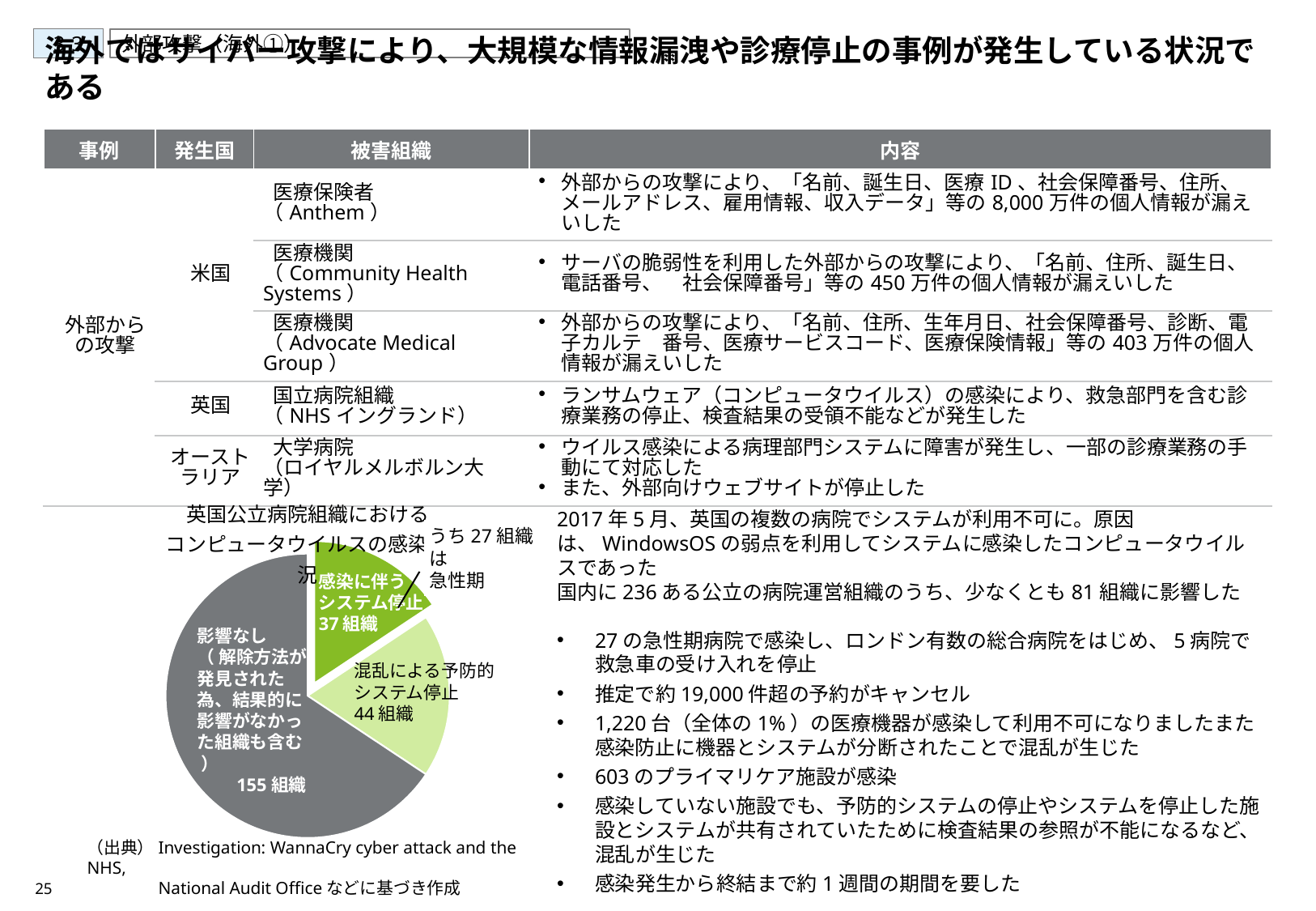
How many slices does the pie chart have? 3 How many more organisations had a preventive system stoppage (混乱による予防的システム停止) than a stoppage due to infection (感染に伴うシステム停止)? 7組織 According to the annotation on the pie chart, how many of the 37 organisations with infection-related system stoppage were acute-care (急性期) organisations? 27組織 In the pie chart, how many organisations had a system stoppage due to infection (感染に伴うシステム停止)? 37組織 Which slice of the pie chart is the largest? 影響なし Which is larger in the pie chart: 影響なし or 混乱による予防的システム停止? 影響なし What type of chart is shown on the slide? Pie chart What is the total number of organisations across all slices of the pie chart? 236組織 In the pie chart, how many organisations had a preventive system stoppage due to disruption (混乱による予防的システム停止)? 44組織 Which slice of the pie chart is the smallest? 感染に伴うシステム停止 What is the title of the pie chart? 英国公立病院組織におけるコンピュータウイルスの感染状況 In the pie chart, how many organisations were not affected (影響なし)? 155組織